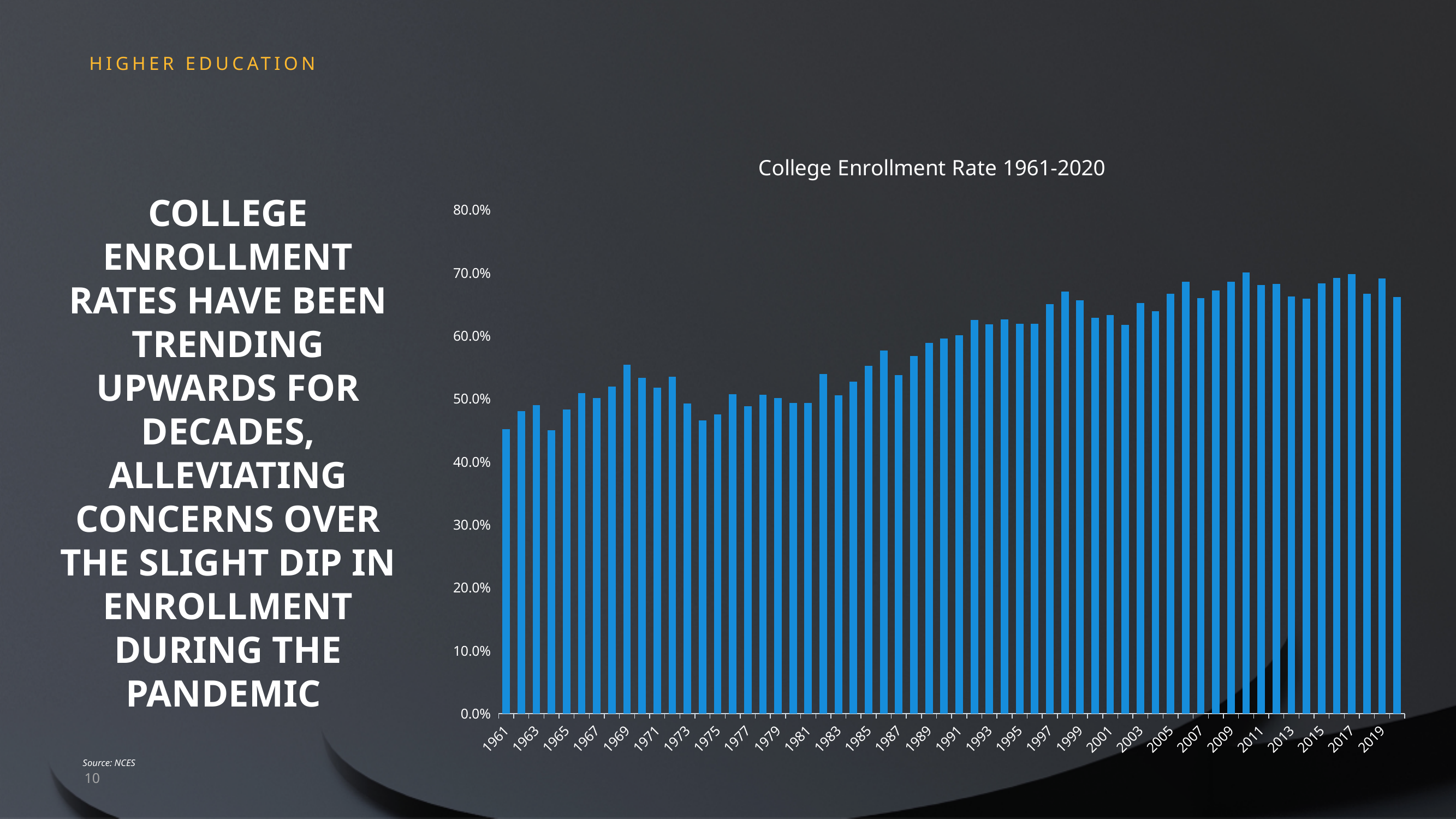
What is the title of the chart? College Enrollment Rate 1961-2020 Which year has the larger value, 1961 or 2019? 2019 Is the value for 1961 greater or less than 50%? less Is the value for 1969 greater or less than 50%? greater Is the value for 1975 greater or less than 50%? less What kind of chart is shown on the slide? bar chart Overall, do the values rise or fall from 1961 to 2020? rise What is the highest value shown on the chart's vertical axis? 80.0% Which year has the larger value, 1975 or 1985? 1985